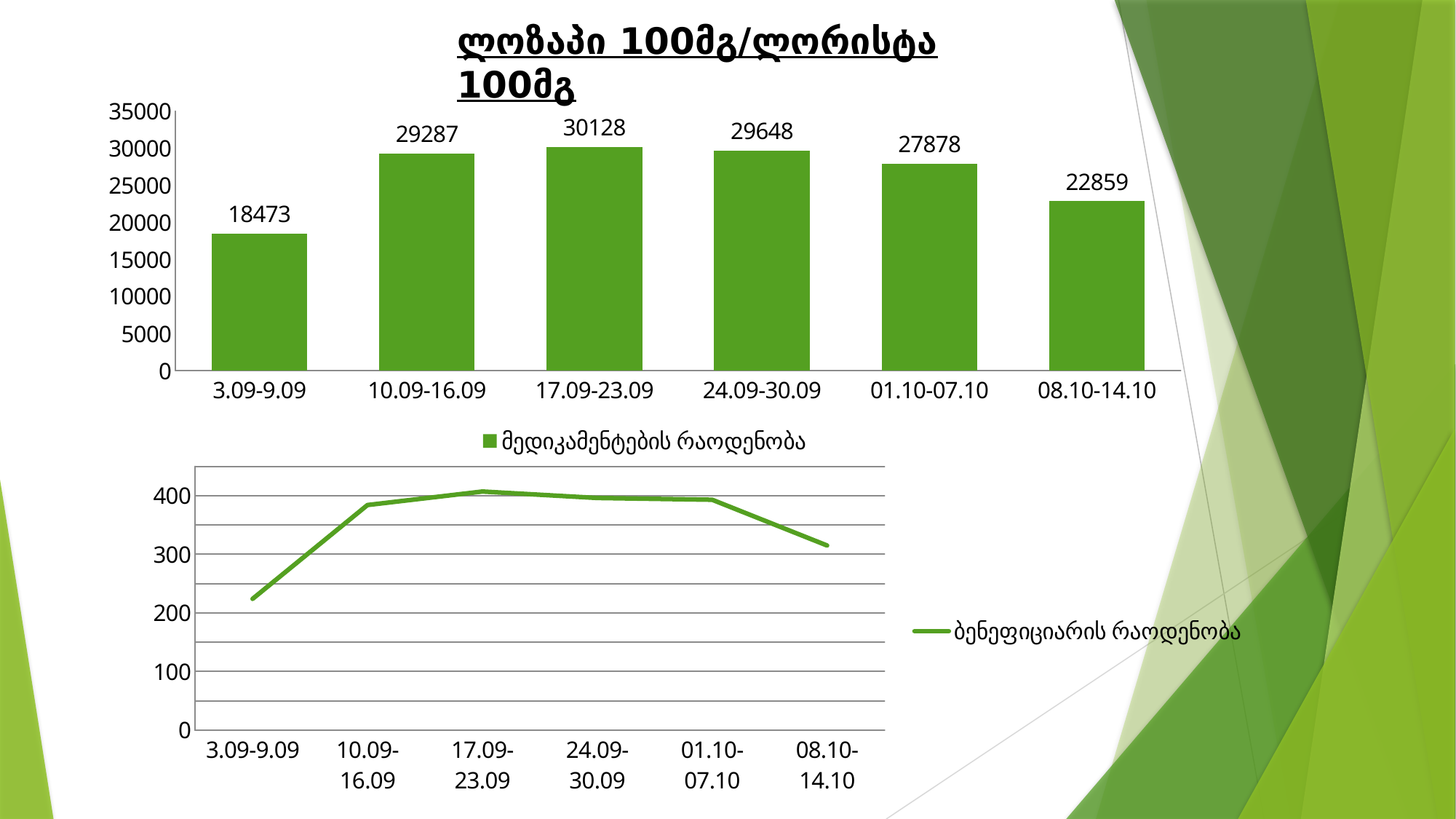
What type of chart is the bottom chart on the slide? Line chart In the bottom line chart, is the value for 08.10-14.10 greater or less than 300? greater In the top bar chart, what is the value for 08.10-14.10? 22859 In the top bar chart, which is larger: the value for 24.09-30.09 or the value for 08.10-14.10? 24.09-30.09 In the top bar chart, what is the difference between the values for 10.09-16.09 and 01.10-07.10? 1409 How many bars are in the top bar chart? 6 In the top bar chart, which period has the highest value? 17.09-23.09 In the top bar chart, which period has the lowest value? 3.09-9.09 In the bottom line chart, is the value for 3.09-9.09 greater or less than 200? greater In the top bar chart, what is the value for 17.09-23.09? 30128 In the top bar chart, what is the value for 3.09-9.09? 18473 What is the legend entry of the bottom line chart? ბენეფიციარის რაოდენობა